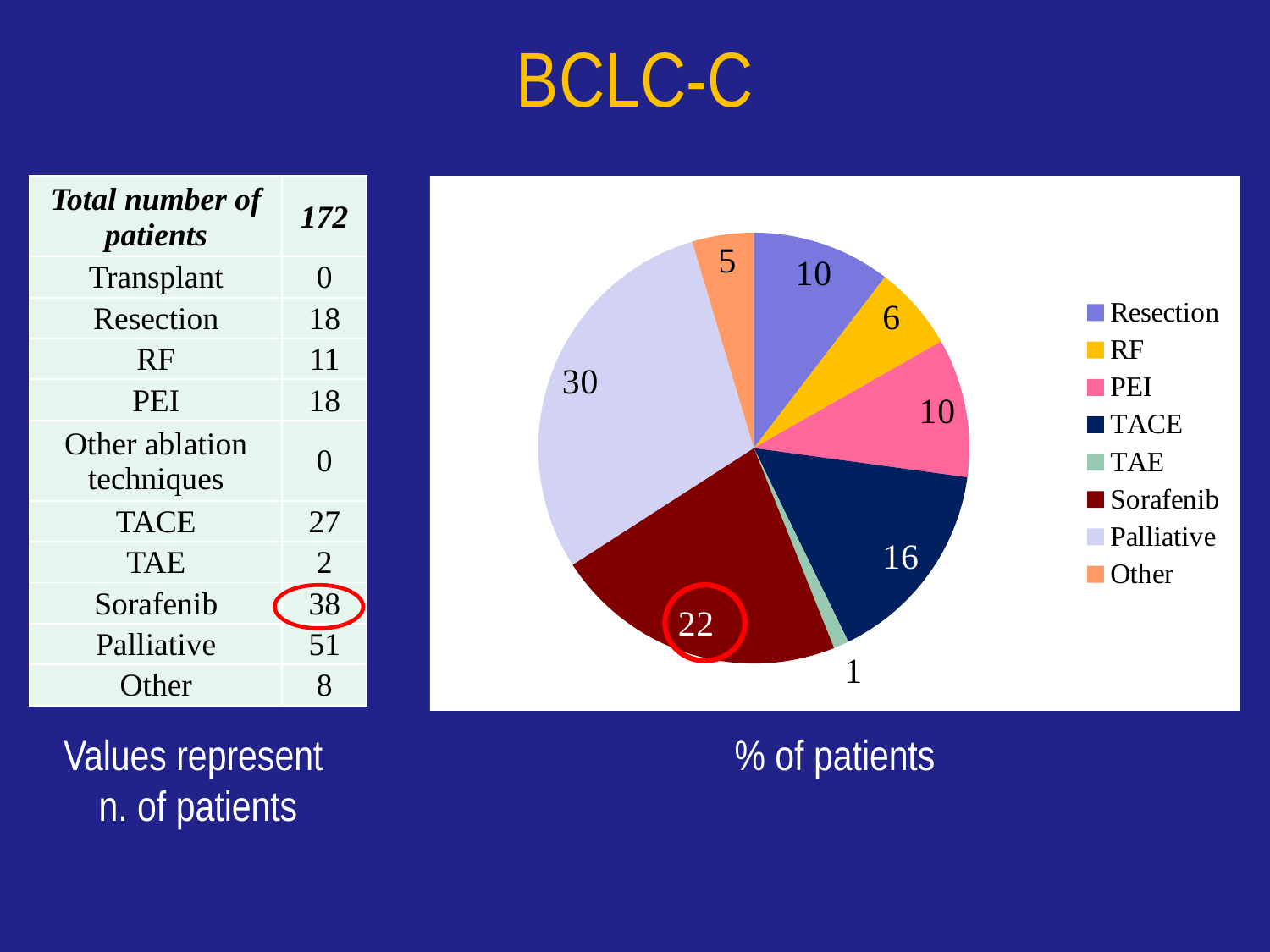
Which category has the smallest slice in the pie chart? TAE What type of chart is shown on the slide? pie chart What value is shown for the TACE slice of the pie chart? 16 What value is shown for the Palliative slice of the pie chart? 30 How many categories does the legend of the pie chart list? 8 What value is shown for the Sorafenib slice of the pie chart? 22 Which category has the largest slice in the pie chart? Palliative What is the difference between the Palliative and Sorafenib values in the pie chart? 8 Which is larger in the pie chart, TACE or PEI? TACE What value is shown for the RF slice of the pie chart? 6 What value is shown for the Other slice of the pie chart? 5 What colour is the Sorafenib slice in the pie chart? dark red